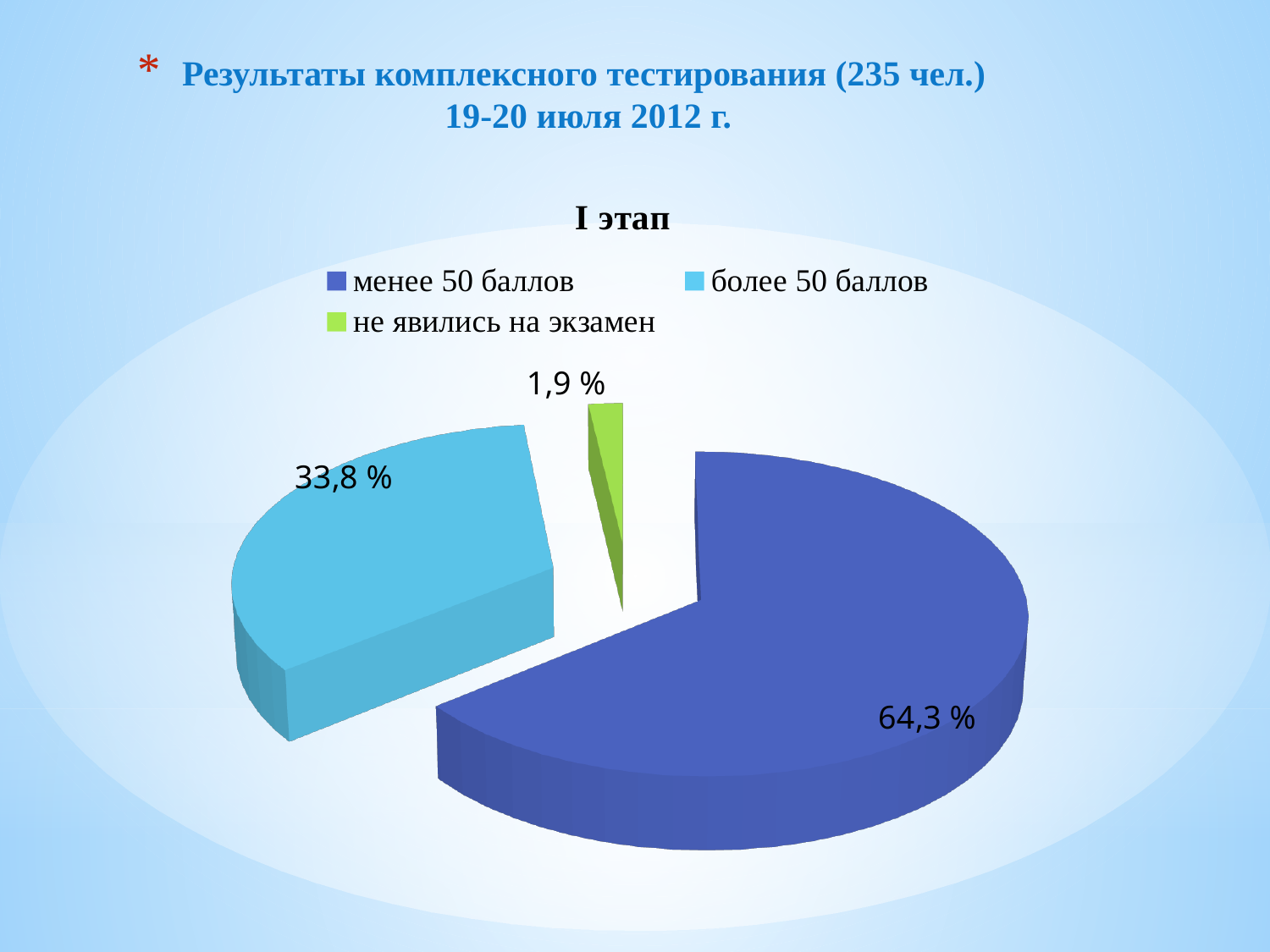
Which category has the smallest slice of the pie? не явились на экзамен What share of the pie is labelled for "более 50 баллов"? 33,8 % What is the difference in percentage points between the "менее 50 баллов" slice and the "более 50 баллов" slice? 30,5 % What is the chart's title? I этап What share of the pie is labelled for "менее 50 баллов"? 64,3 % Which category has the largest slice of the pie? менее 50 баллов Which is larger: the share for "менее 50 баллов" or the share for "более 50 баллов"? менее 50 баллов How many slices does the pie chart have? 3 What share of the pie is labelled for "не явились на экзамен"? 1,9 % Which colour is used for the "не явились на экзамен" slice? green What kind of chart is shown on the slide? pie chart How many entries does the legend list? 3